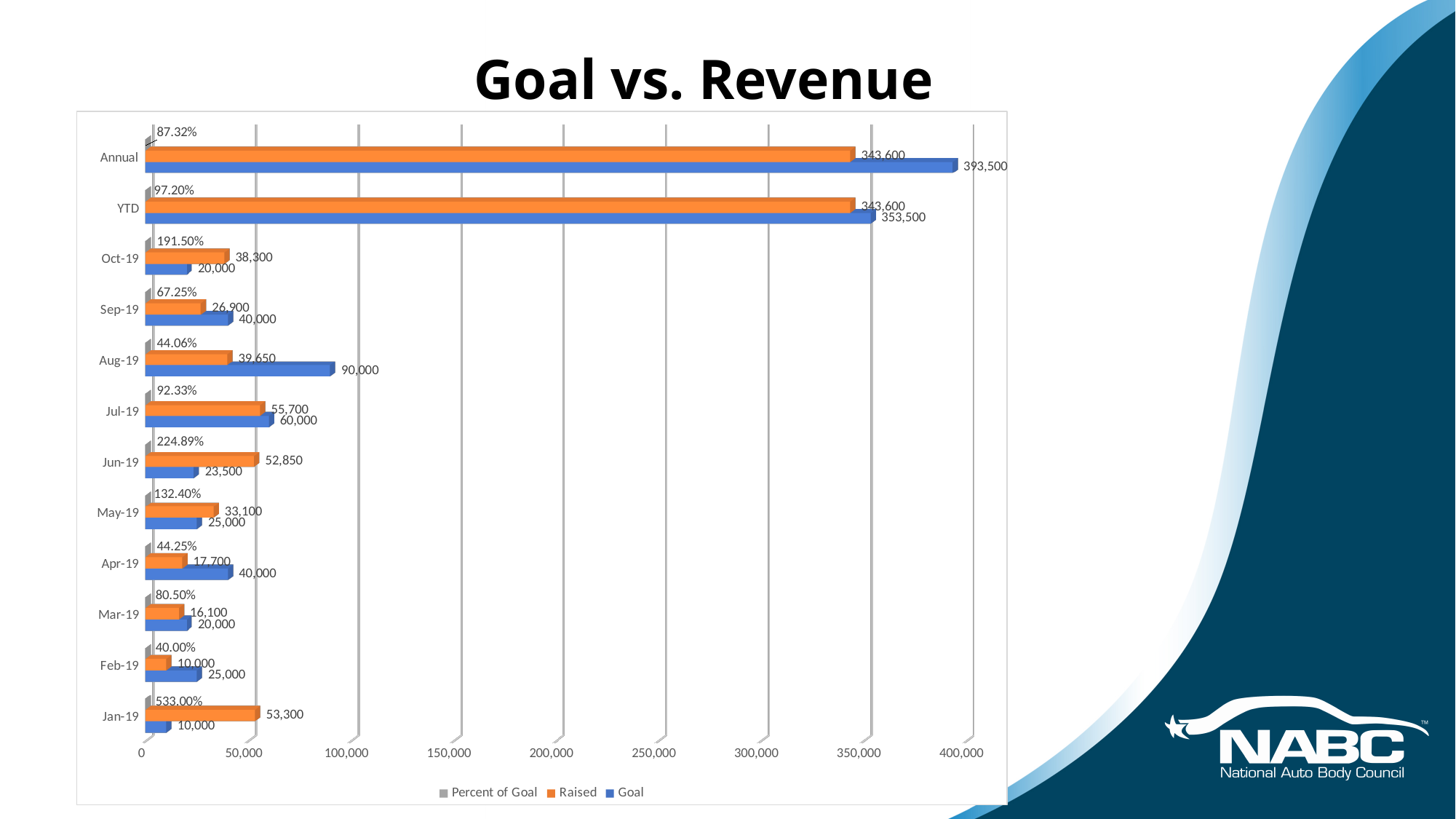
What is the Raised value for Jun-19? 52,850 How many categories are shown on the vertical axis? 12 What is the Percent of Goal for Jan-19? 533.00% Among the monthly categories (Jan-19 to Oct-19), which month has the lowest Raised value? Feb-19 What is the Goal value for Aug-19? 90,000 What is the Goal value for Annual? 393,500 How many series does the legend list? 3 Which is larger for Jul-19, the Raised value or the Goal value? Goal Among the monthly categories (Jan-19 to Oct-19), which month has the highest Goal value? Aug-19 What is the title of the chart? Goal vs. Revenue What is the difference between the Goal and Raised values for Annual? 49,900 What type of chart is shown on the slide? Bar chart